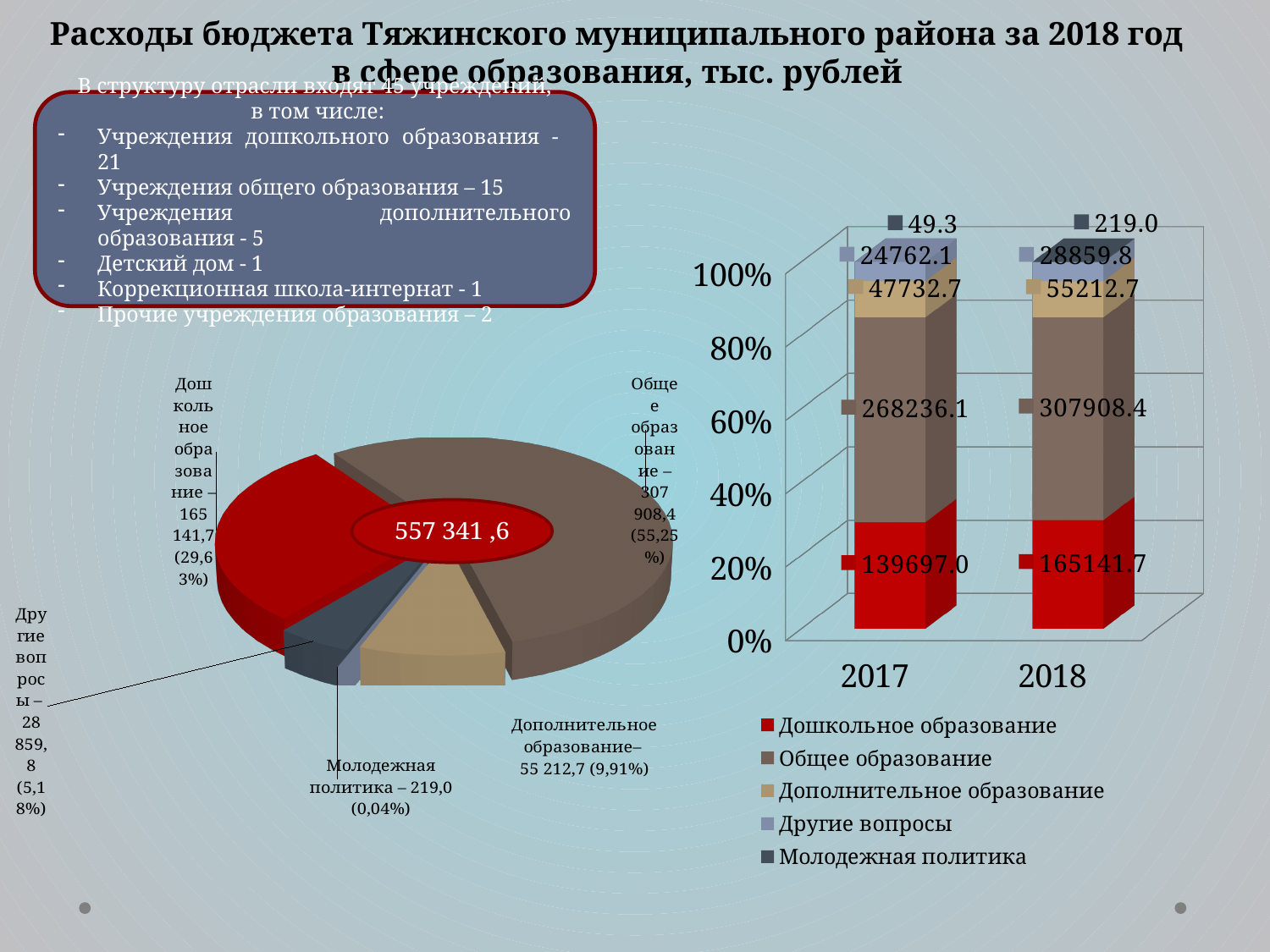
In the bar chart on the right, which series has the highest value in 2018? Общее образование In the pie chart on the left, what share does Общее образование have? 55,25% What kind of chart is the chart on the left of the slide? Pie chart In the bar chart on the right, which year has the larger value for Другие вопросы, 2017 or 2018? 2018 In the bar chart on the right, what is the difference between the Дополнительное образование values for 2018 and 2017? 7480.0 In the bar chart on the right, what is the value for Дошкольное образование in 2017? 139697.0 In the bar chart on the right, what is the value for Общее образование in 2018? 307908.4 In the bar chart on the right, how many series does the legend list? 5 In the bar chart on the right, what is the value for Молодежная политика in 2017? 49.3 In the pie chart on the left, what total value is printed in the centre of the pie? 557 341 ,6 In the pie chart on the left, which slice is the smallest? Молодежная политика In the bar chart on the right, how many categories are shown on the x axis? 2